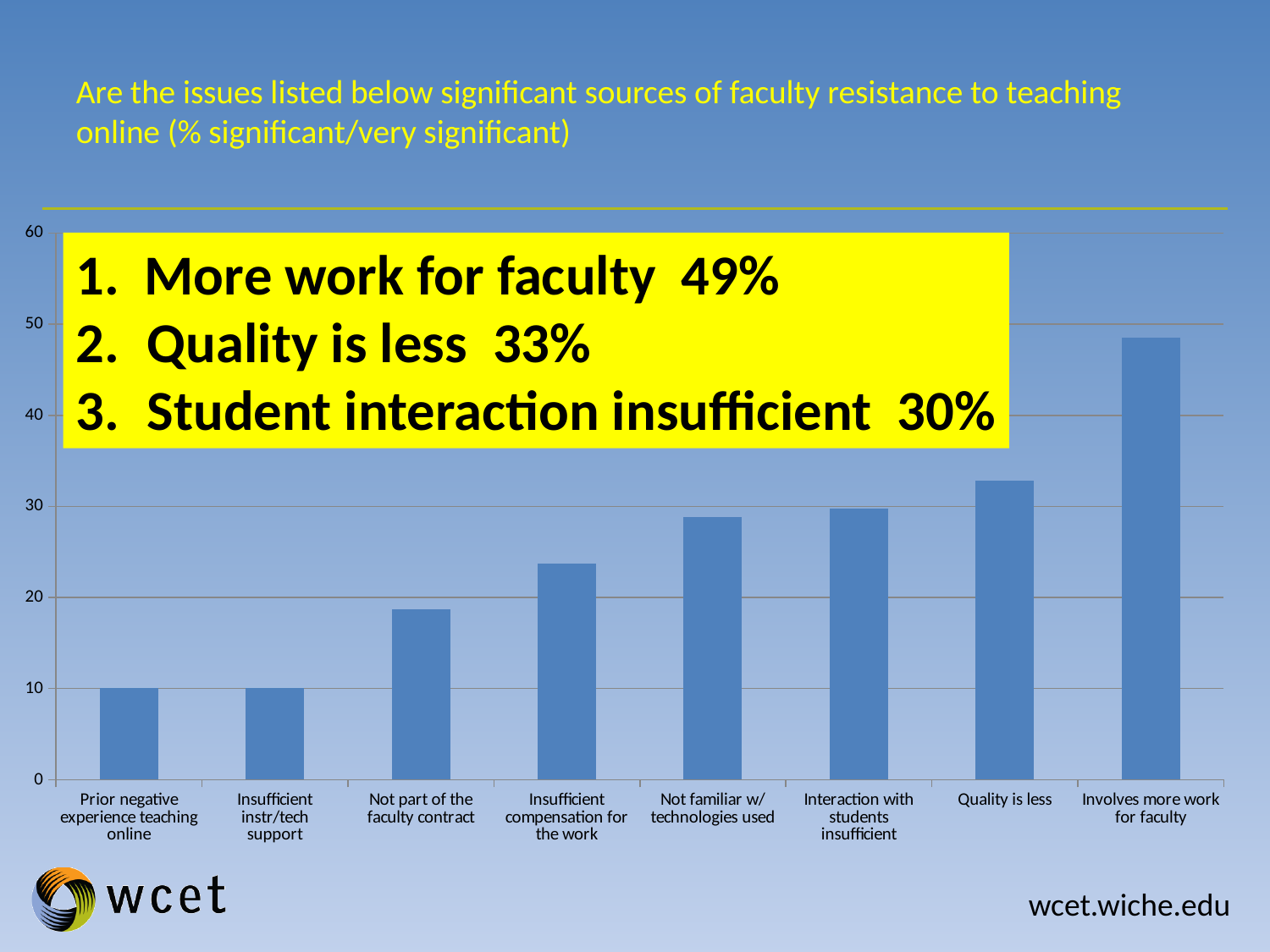
Is the value for 'Insufficient compensation for the work' greater or less than 20? greater Which has a larger value: 'Quality is less' or 'Not part of the faculty contract'? Quality is less What is the difference in percentage points between 'More work for faculty' (49%) and 'Quality is less' (33%)? 16 Which issue has the highest bar on the chart? Involves more work for faculty Is the value for 'Not part of the faculty contract' greater or less than 20? less How many categories (issues) are plotted on the chart? 8 Do the bar values generally rise or fall moving from left to right along the x axis? rise According to the slide, what percentage is given for 'Quality is less'? 33% According to the slide, what percentage is given for 'Student interaction insufficient'? 30% What type of chart is shown on the slide? bar chart Is the value for 'Not familiar w/ technologies used' greater or less than 30? less According to the slide, what percentage of respondents rated 'More work for faculty' as significant/very significant? 49%